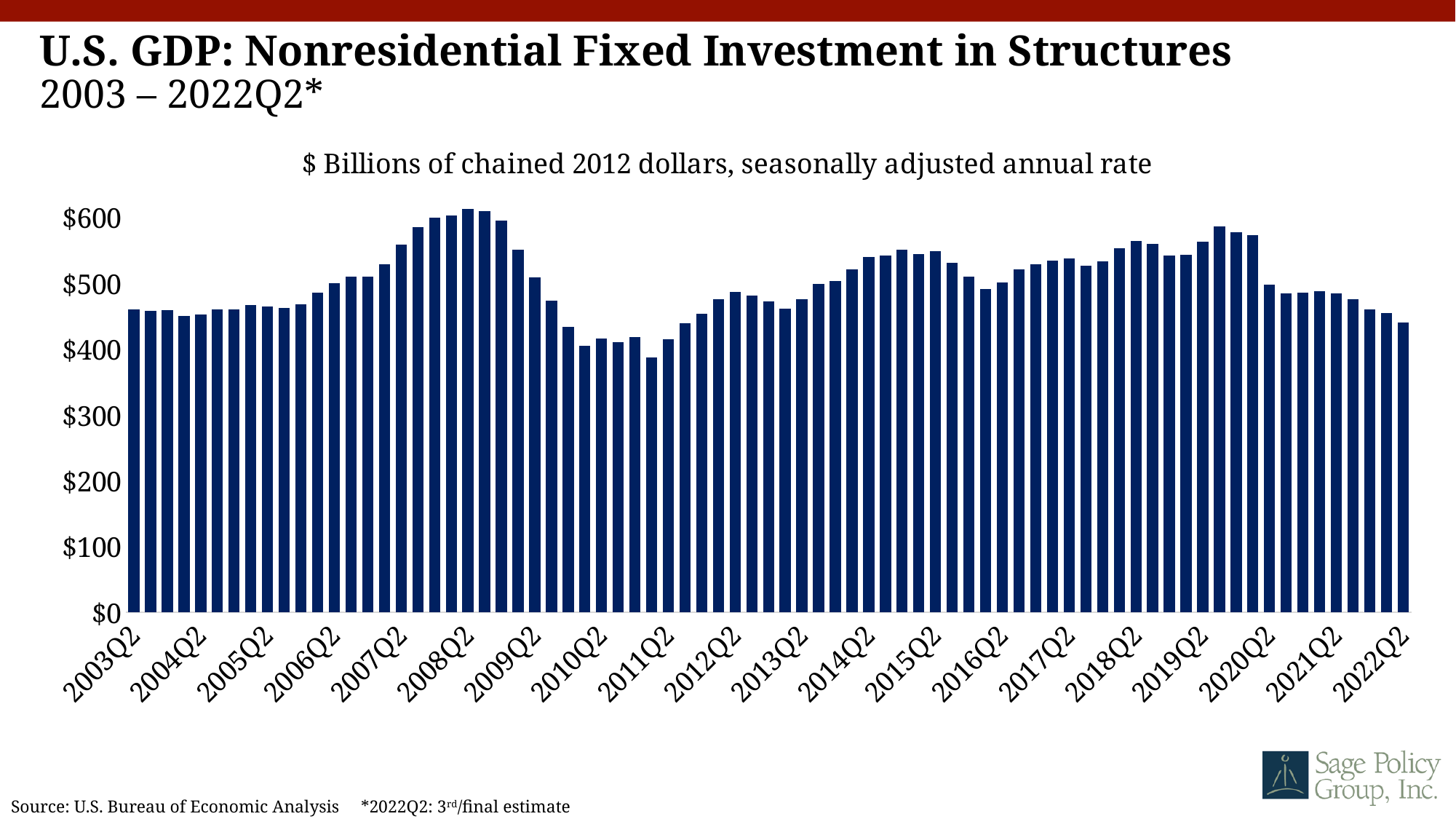
In what units are the values on the chart expressed, according to the subtitle? $ Billions of chained 2012 dollars, seasonally adjusted annual rate Is the value for 2008Q2 greater or less than $500? greater Is the value for 2010Q2 greater or less than $500? less What is the title of the chart on the slide? U.S. GDP: Nonresidential Fixed Investment in Structures How many quarter labels are shown on the x axis? 20 What kind of chart is shown on the slide? Bar chart Which is larger, the value for 2008Q2 or the value for 2011Q2? 2008Q2 Do the values rise or fall from 2019Q2 to 2022Q2? fall Which is larger, the value for 2007Q2 or the value for 2010Q2? 2007Q2 Is the value for 2022Q2 greater or less than $500? less